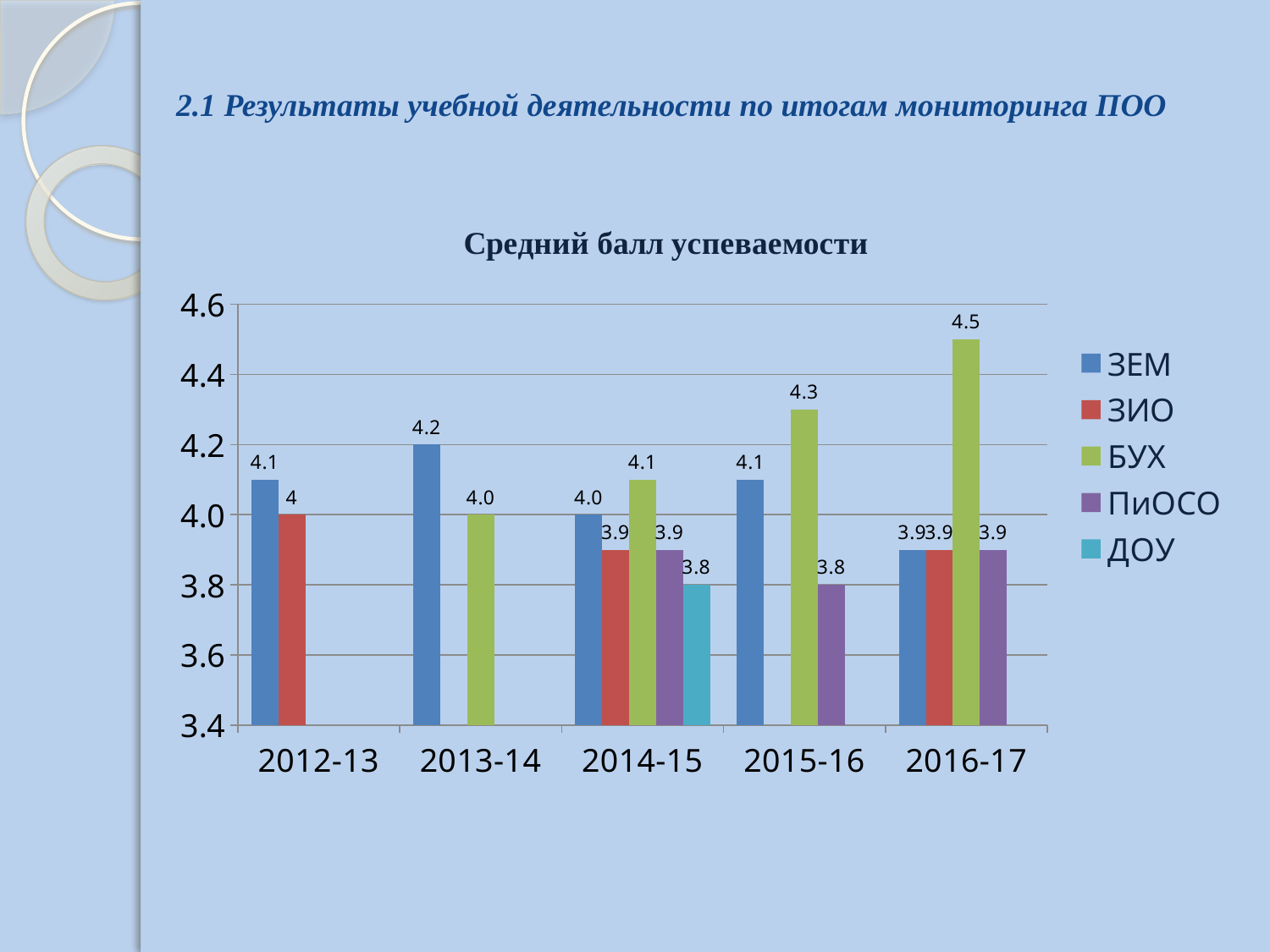
What is the difference between the БУХ and ЗЕМ values in 2016-17? 0.6 What is the value for ПиОСО in 2015-16? 3.8 What kind of chart is shown on the slide? bar chart How many academic years are shown on the x axis? 5 What is the value for БУХ in 2016-17? 4.5 What is the title of the chart? Средний балл успеваемости In which year does БУХ have its highest value? 2016-17 What is the value for ЗЕМ in 2013-14? 4.2 Do the values for БУХ rise or fall from 2013-14 to 2016-17? rise How many series does the legend list? 5 What is the value for ДОУ in 2014-15? 3.8 In 2015-16, which is larger: the value for БУХ or the value for ЗЕМ? БУХ